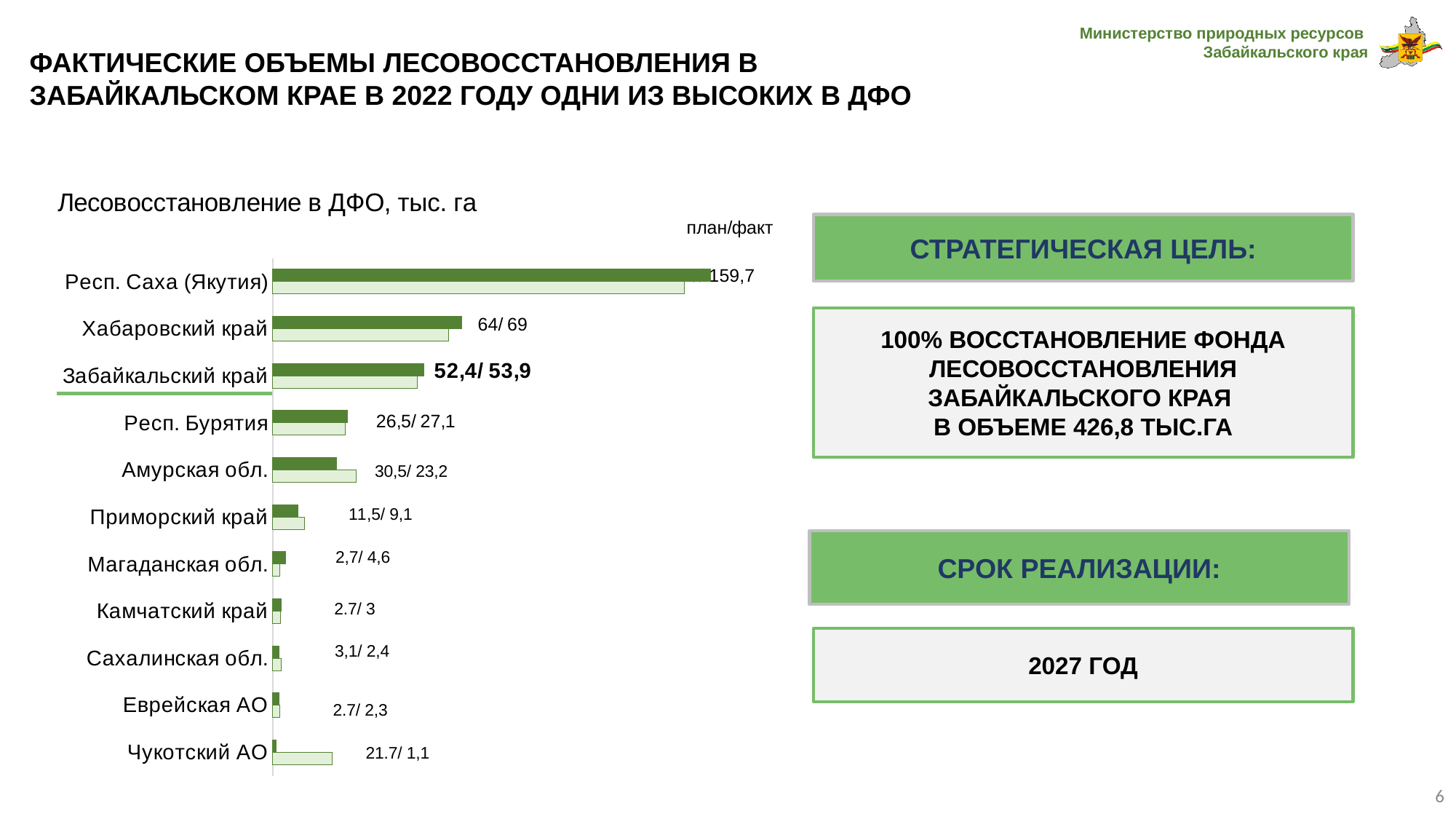
What are the plan and fact values (план/факт) printed for Амурская обл.? 30,5/ 23,2 What are the plan and fact values (план/факт) printed for Чукотский АО? 21.7/ 1,1 Which region has the larger fact value: Хабаровский край or Забайкальский край? Хабаровский край What are the plan and fact values (план/факт) printed for Хабаровский край? 64/ 69 What is the title of the chart on the slide? Лесовосстановление в ДФО, тыс. га What are the plan and fact values (план/факт) printed for Забайкальский край? 52,4/ 53,9 By how much does the fact value for Хабаровский край exceed its plan value? 5 What value is printed for Респ. Саха (Якутия) in the chart? 159,7 Which region has the highest reforestation value in the chart? Респ. Саха (Якутия) What is the difference between the plan and fact values for Респ. Бурятия? 0,6 How many regions are listed in the chart "Лесовосстановление в ДФО, тыс. га"? 11 What kind of chart is shown on the slide? bar chart